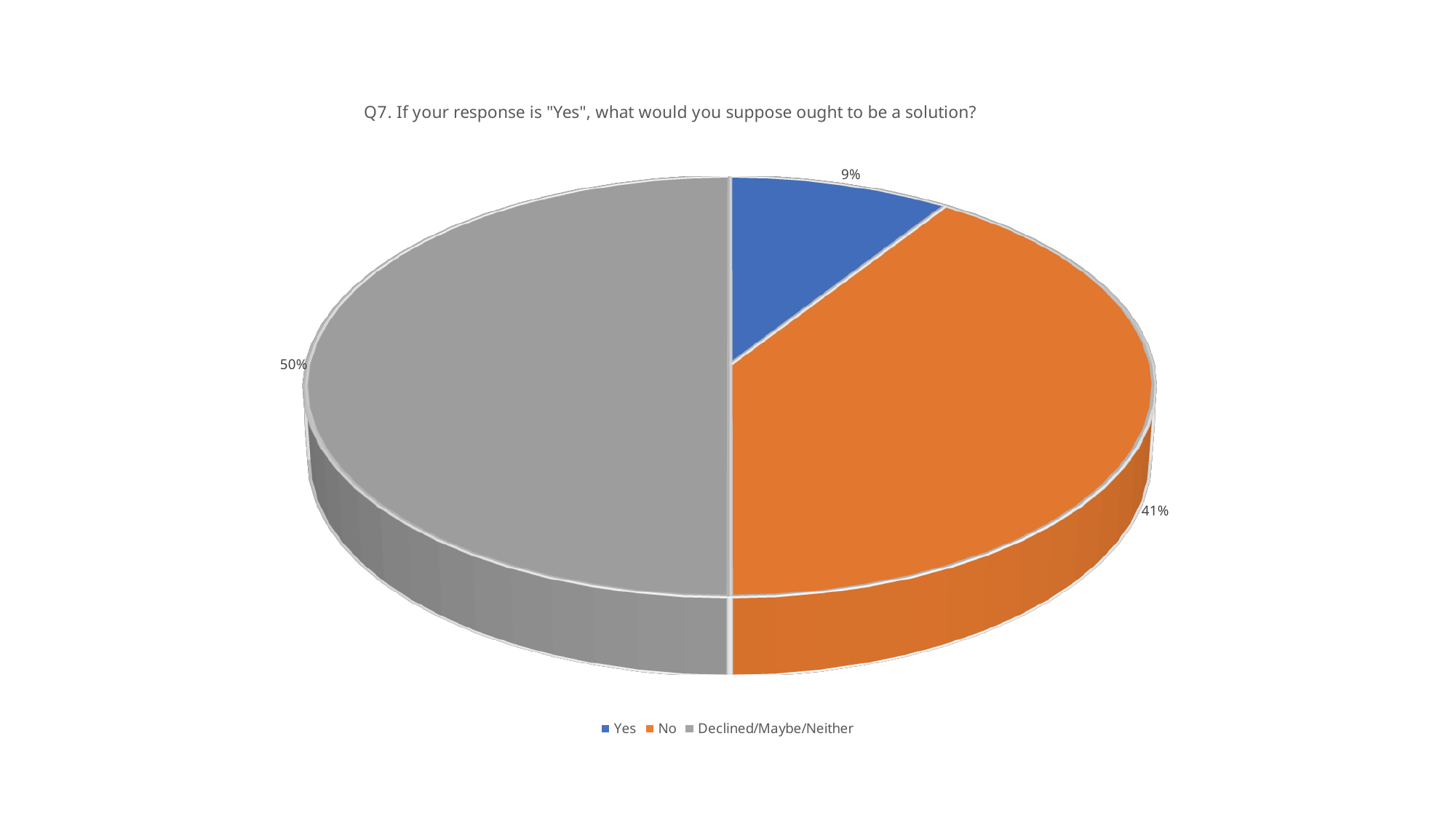
What kind of chart is shown on the slide? Pie chart Which is larger, the "No" slice or the "Yes" slice? No What percentage of the pie is the "Yes" slice? 9% Which category has the smallest share of the pie? Yes What is the title of the chart? Q7. If your response is "Yes", what would you suppose ought to be a solution? What colour is the "No" slice in the pie chart? Orange What is the difference in percentage points between the "Declined/Maybe/Neither" slice and the "No" slice? 9 How many slices does the pie chart have? 3 What is the difference in percentage points between the "No" slice and the "Yes" slice? 32 Which category has the largest share of the pie? Declined/Maybe/Neither What percentage of the pie is the "No" slice? 41% What percentage of the pie is the "Declined/Maybe/Neither" slice? 50%